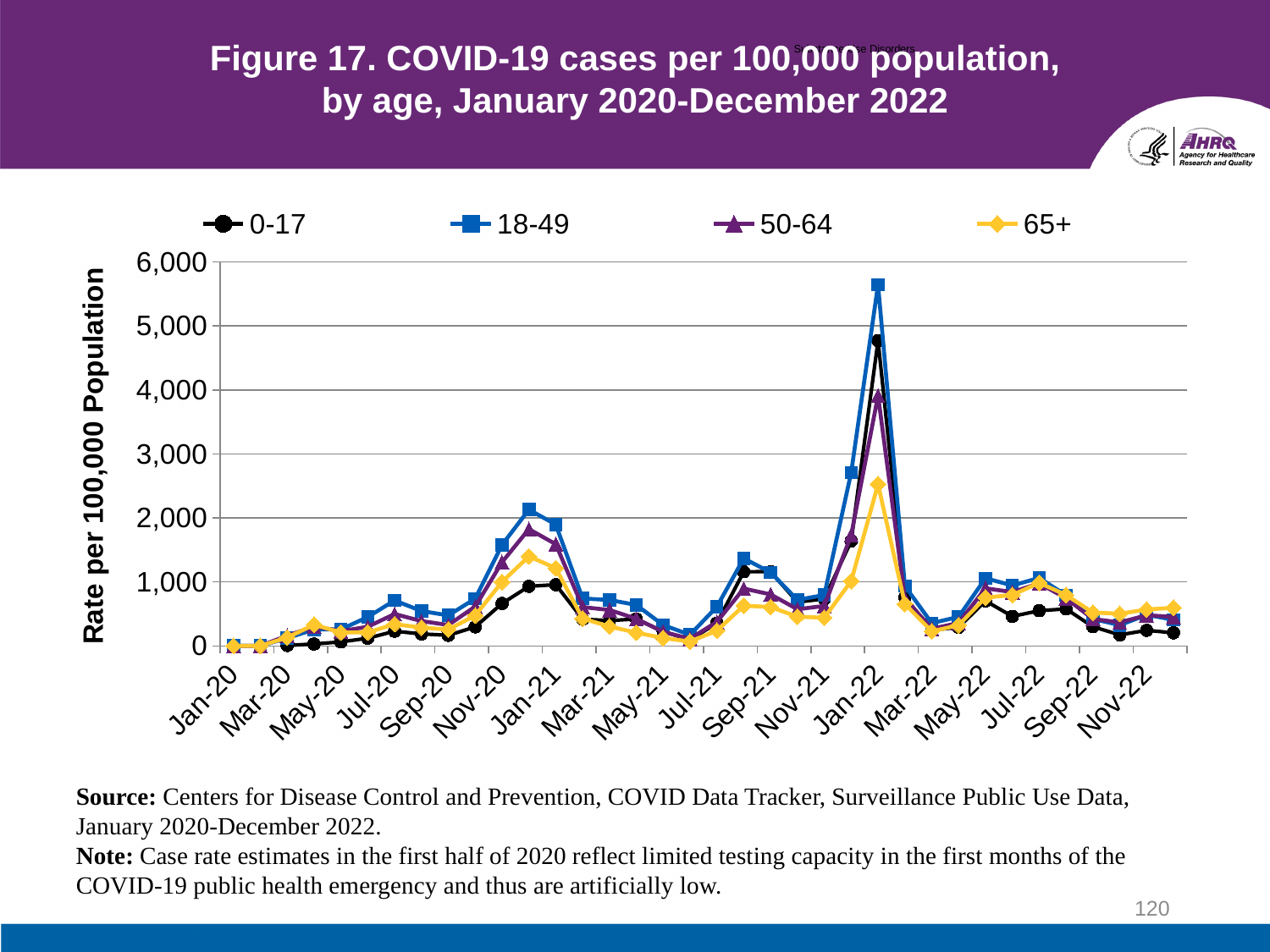
What kind of chart is shown on the slide? line chart Which age group reaches the highest rate in Jan-22? 18-49 Which age group has the highest rate in Jan-21? 18-49 In Jan-22, which is larger: the rate for 18-49 or the rate for 65+? 18-49 Do the rates for all age groups rise or fall between Jan-22 and Mar-22? fall Is the value for 0-17 in Jan-22 greater or less than 4,000? greater Is the value for 65+ in Jan-22 greater or less than 3,000? less How many series does the legend list? 4 What is the title of the vertical axis? Rate per 100,000 Population Which age group has the lowest rate at the Jan-22 peak? 65+ Is the value for 18-49 in Jan-21 greater or less than 1,500? greater